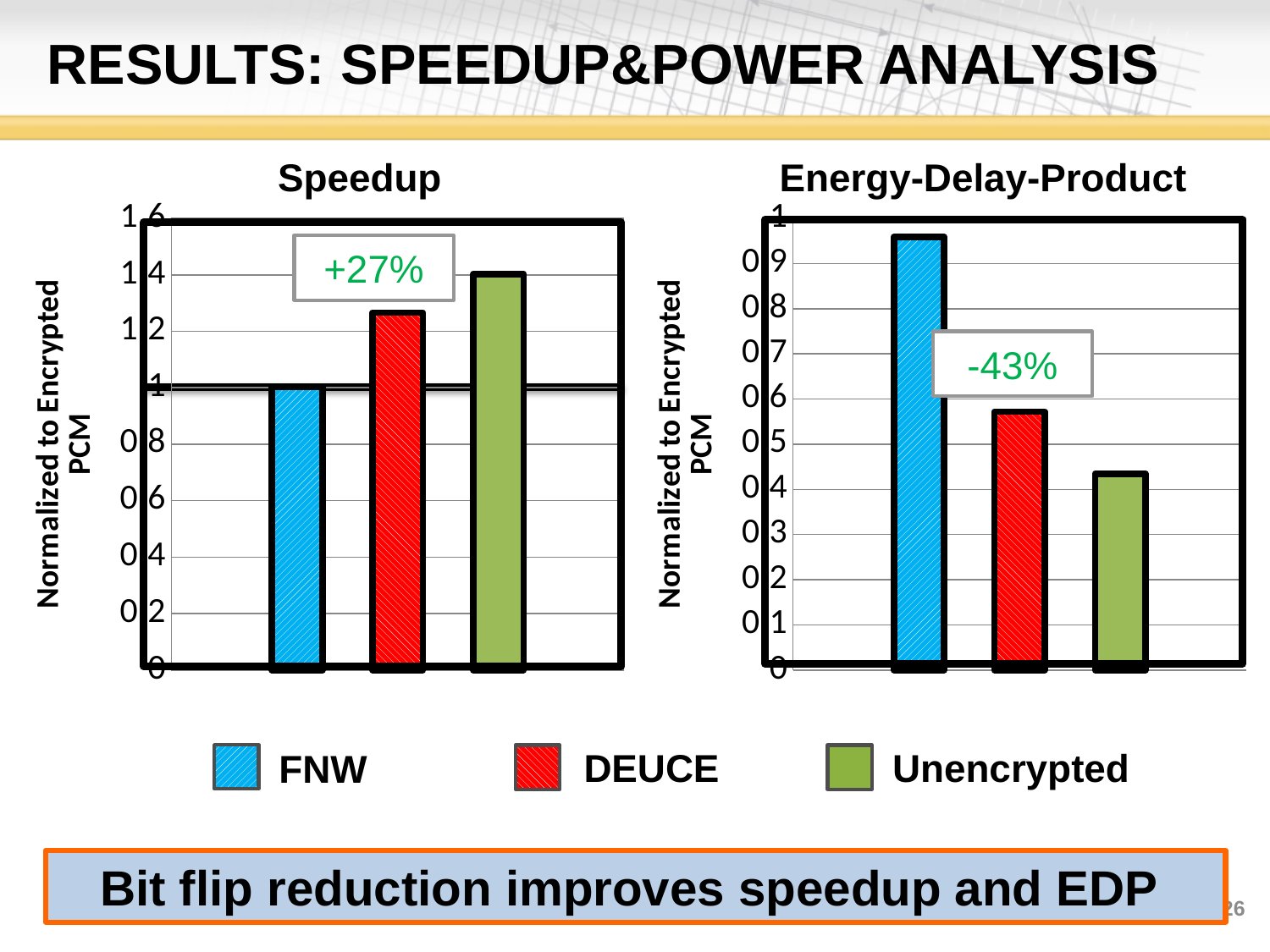
In the Energy-Delay-Product chart, which is larger, the value for FNW or the value for Unencrypted? FNW What percentage change is annotated on the Energy-Delay-Product chart? -43% In the Speedup chart, is the value for DEUCE greater or less than 1.2? greater What percentage change is annotated on the Speedup chart? +27% In the Speedup chart, which series has the lowest value? FNW What kind of chart is the Speedup chart? bar chart How many series does the legend list? 3 In the Speedup chart, how many bars are plotted? 3 In the Speedup chart, which series has the highest value? Unencrypted In the Energy-Delay-Product chart, which series has the highest value? FNW In the Energy-Delay-Product chart, which series has the lowest value? Unencrypted In the Energy-Delay-Product chart, is the value for DEUCE greater or less than 0.6? less